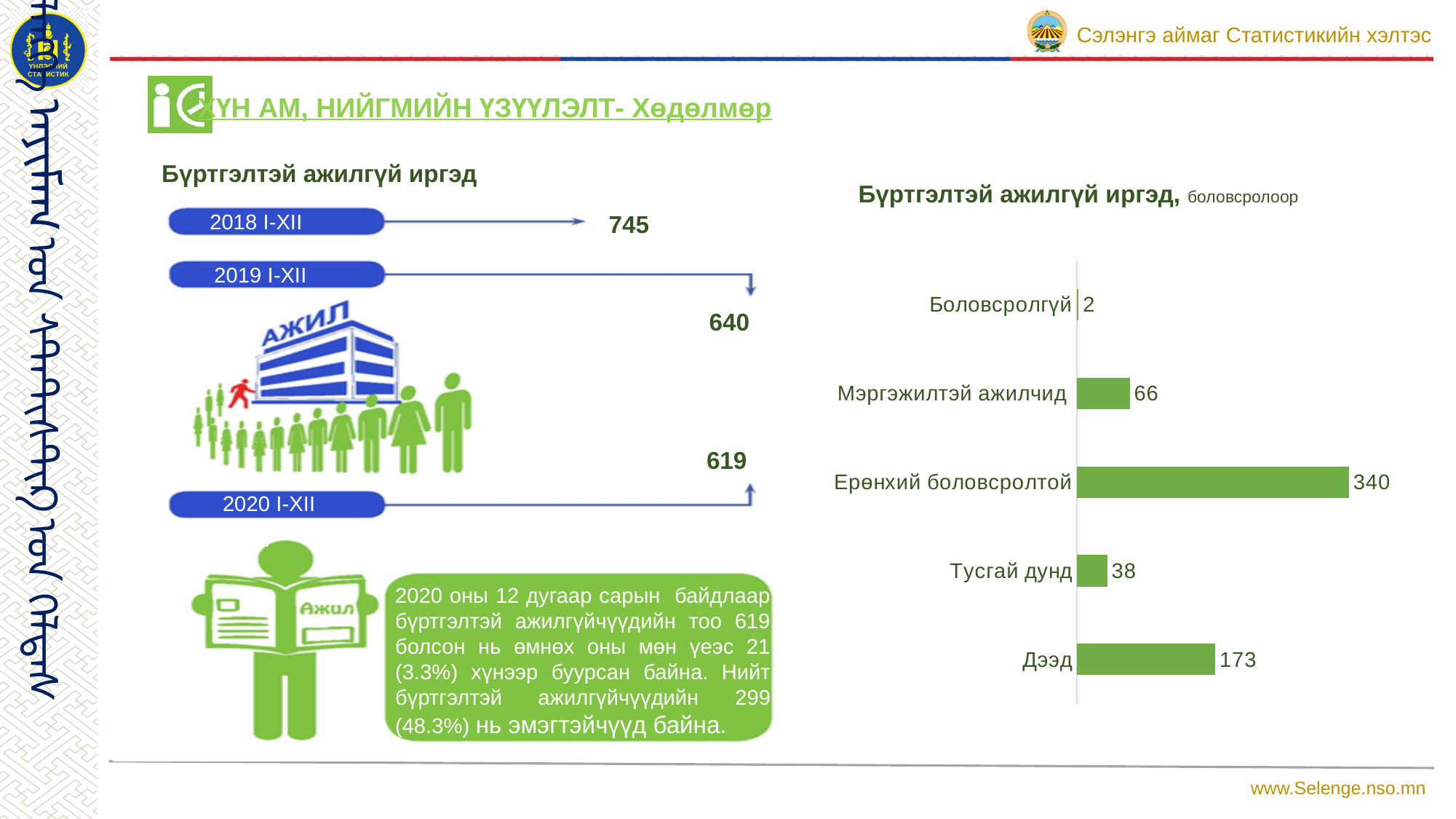
In the chart 'Бүртгэлтэй ажилгүй иргэд, боловсролоор', what is the difference between the values for Ерөнхий боловсролтой and Дээд? 167 In the chart 'Бүртгэлтэй ажилгүй иргэд, боловсролоор', which is larger: the value for Дээд or the value for Мэргэжилтэй ажилчид? Дээд In the chart 'Бүртгэлтэй ажилгүй иргэд, боловсролоор', what is the difference between the values for Мэргэжилтэй ажилчид and Тусгай дунд? 28 In the chart 'Бүртгэлтэй ажилгүй иргэд, боловсролоор', which category has the highest value? Ерөнхий боловсролтой In the chart 'Бүртгэлтэй ажилгүй иргэд, боловсролоор', which category has the lowest value? Боловсролгүй In the chart 'Бүртгэлтэй ажилгүй иргэд, боловсролоор', what is the value for Мэргэжилтэй ажилчид? 66 What colour are the bars in the chart 'Бүртгэлтэй ажилгүй иргэд, боловсролоор'? Green In the chart 'Бүртгэлтэй ажилгүй иргэд, боловсролоор', what is the value for Дээд? 173 In the chart 'Бүртгэлтэй ажилгүй иргэд, боловсролоор', what is the value for Тусгай дунд? 38 In the chart 'Бүртгэлтэй ажилгүй иргэд, боловсролоор', what is the value for Ерөнхий боловсролтой? 340 How many categories are shown in the chart 'Бүртгэлтэй ажилгүй иргэд, боловсролоор'? 5 What kind of chart is 'Бүртгэлтэй ажилгүй иргэд, боловсролоор'? Bar chart